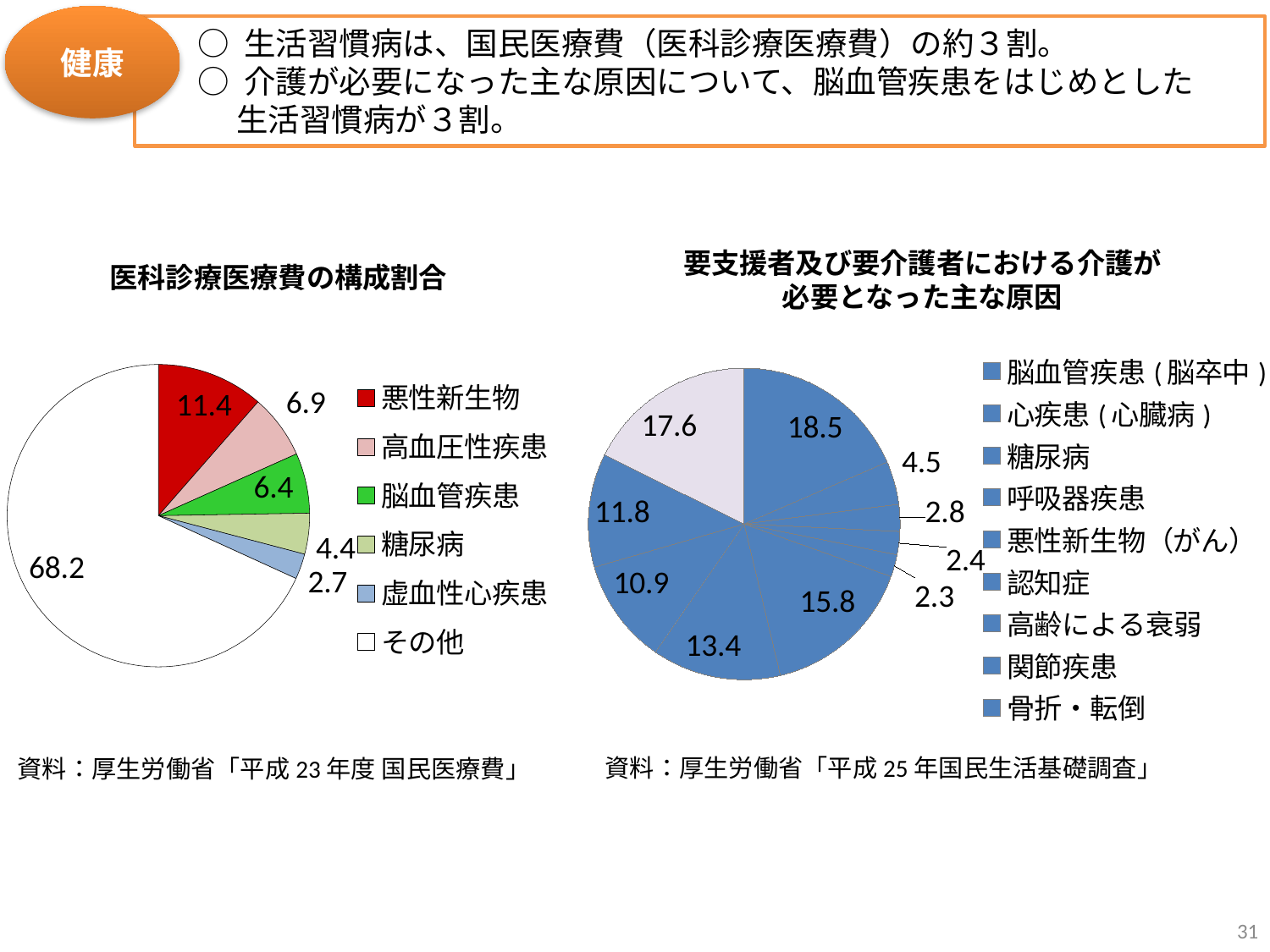
In the 医科診療医療費の構成割合 chart, what is the value for 脳血管疾患? 6.4 In the 医科診療医療費の構成割合 chart, which category has the smallest slice? 虚血性心疾患 How many entries does the legend of the 要支援者及び要介護者における介護が必要となった主な原因 chart list? 9 In the 医科診療医療費の構成割合 chart, which is larger, 糖尿病 or 脳血管疾患? 脳血管疾患 In the 医科診療医療費の構成割合 chart, what is the value for 虚血性心疾患? 2.7 In the 医科診療医療費の構成割合 chart, what is the difference between the values for 悪性新生物 and 高血圧性疾患? 4.5 How many entries does the legend of the 医科診療医療費の構成割合 chart list? 6 In the 医科診療医療費の構成割合 chart, which category has the largest slice? その他 What kind of chart is the 医科診療医療費の構成割合 chart on the left? pie chart In the 要支援者及び要介護者における介護が必要となった主な原因 chart, what is the smallest value labeled on a slice? 2.3 In the 要支援者及び要介護者における介護が必要となった主な原因 chart, what is the largest value labeled on a slice? 18.5 In the 医科診療医療費の構成割合 chart, what is the value for 悪性新生物? 11.4